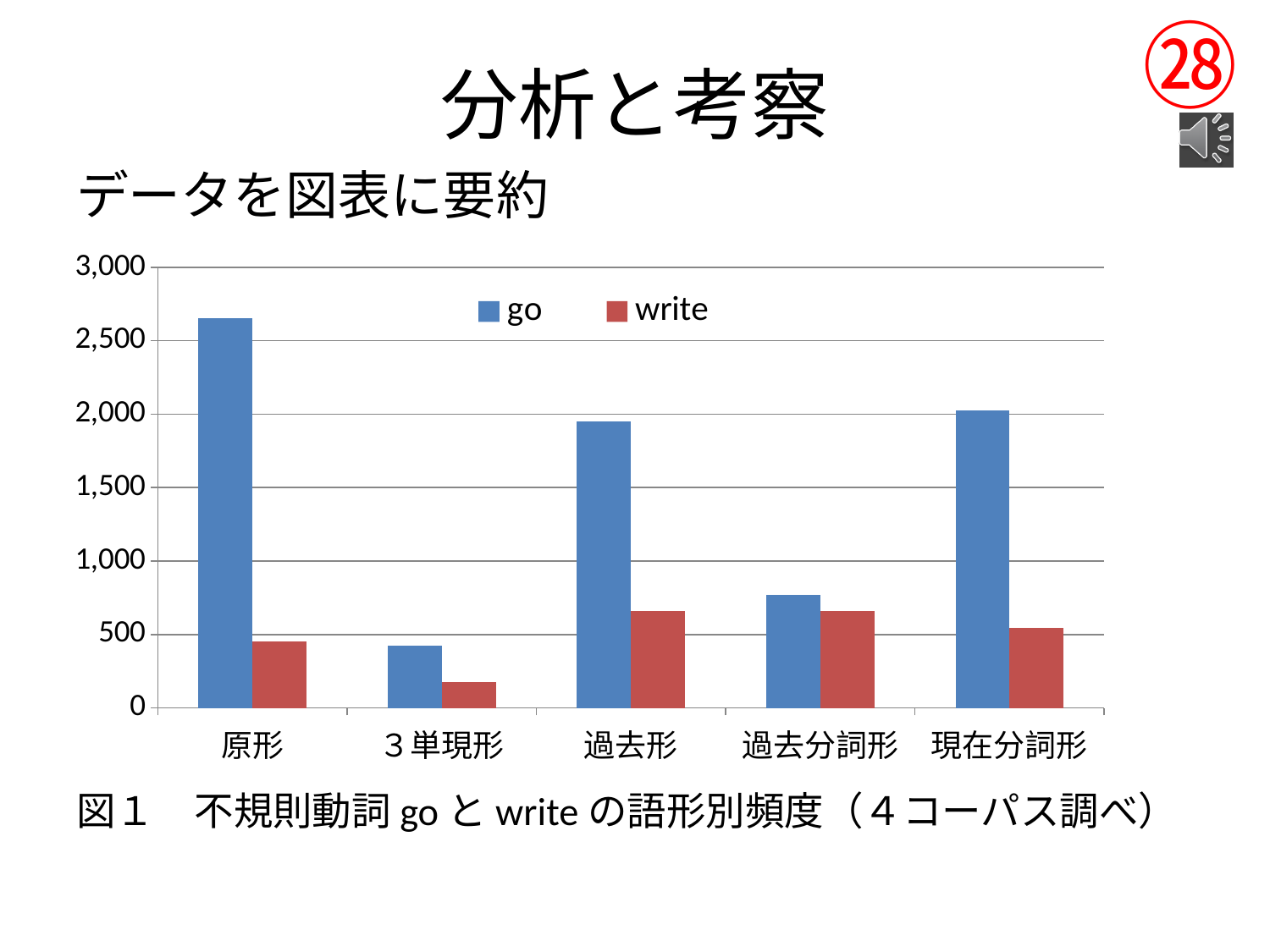
What are the two entries listed in the chart legend? go and write Is the value for go in the 原形 category greater or less than 2,500? greater Which category has the lowest value for the go series? ３単現形 In the 原形 category, which series has the larger value, go or write? go Is the value for go in the ３単現形 category greater or less than 500? less Which category has the lowest value for the write series? ３単現形 How many categories are shown on the x axis? 5 Which category has the highest value for the go series? 原形 How many series does the legend list? 2 Is the value for write in the 過去形 category greater or less than 500? greater What kind of chart is shown on the slide? bar chart